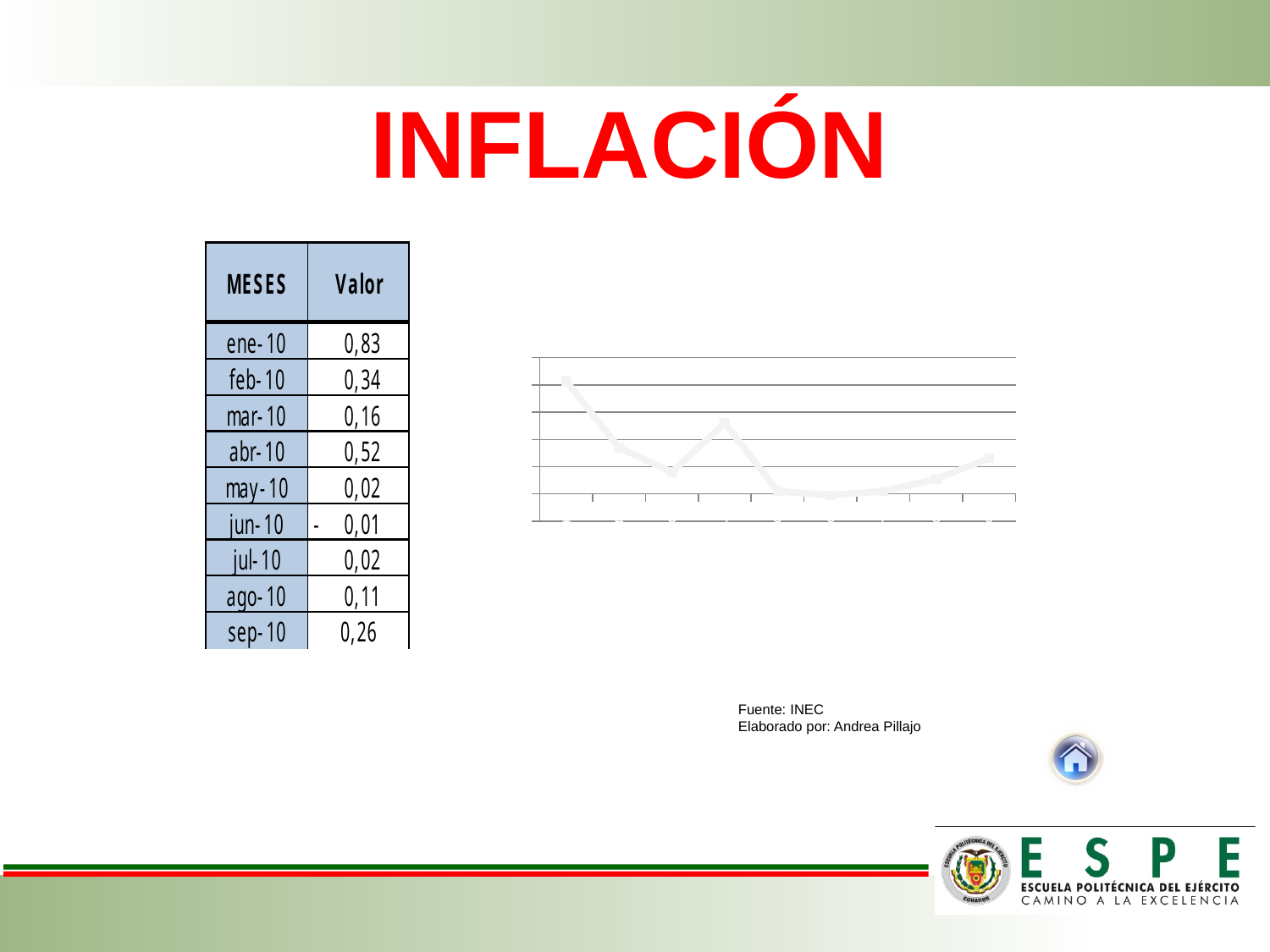
Which point on the line chart is the highest: the first or the fourth? the first How many data points are plotted on the line chart? 9 Does the line rise or fall between the first and second points on the chart? fall What kind of chart is shown on the slide? line chart Does the line rise or fall between the third and fourth points on the chart? rise According to the table on the slide, what is the inflation value for ene-10? 0,83 Does the line rise or fall over the last three points on the chart? rise According to the table on the slide, which month has the lowest inflation value? jun-10 According to the table on the slide, what is the inflation value for abr-10? 0,52 According to the table on the slide, what is the difference between the values for ene-10 and feb-10? 0,49 What is the title of the slide containing the chart? INFLACIÓN According to the table on the slide, which month has the highest inflation value? ene-10